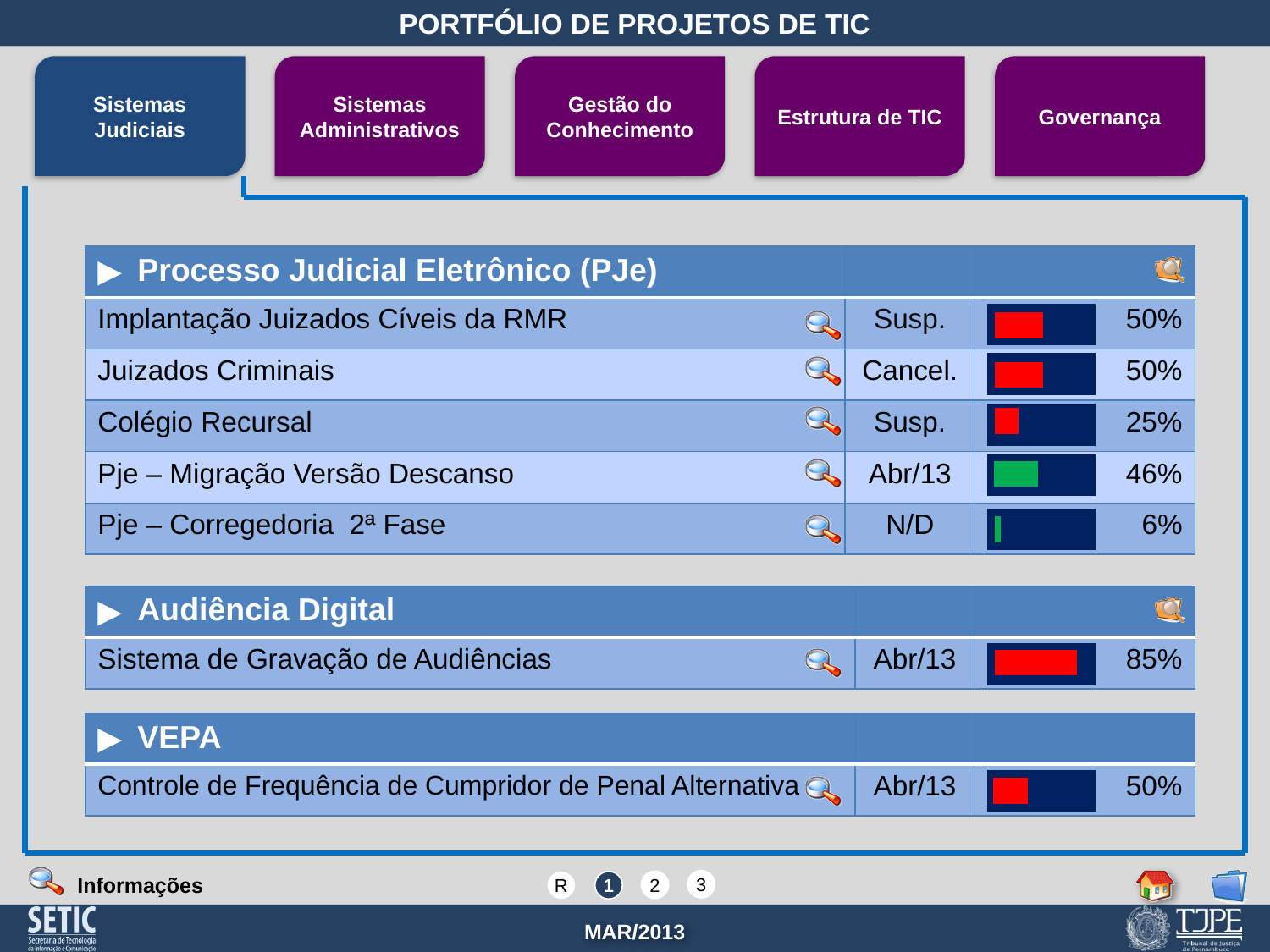
What completion percentage is shown for the project 'Sistema de Gravação de Audiências'? 85% How many projects with progress bars are shown on the slide in total? 7 What completion percentage is shown for 'Pje – Migração Versão Descanso'? 46% Which has a higher completion percentage: 'Colégio Recursal' or 'Pje – Migração Versão Descanso'? Pje – Migração Versão Descanso Which project has the lowest completion percentage on the slide? Pje – Corregedoria 2ª Fase What completion percentage is shown for 'Colégio Recursal'? 25% What completion percentage is shown for 'Pje – Corregedoria 2ª Fase'? 6% What is the difference in percentage points between the completion of 'Sistema de Gravação de Audiências' and 'Pje – Corregedoria 2ª Fase'? 79 percentage points Which project has the highest completion percentage on the slide? Sistema de Gravação de Audiências Which project's progress bar is coloured green rather than red? Pje – Migração Versão Descanso and Pje – Corregedoria 2ª Fase How many projects are listed under the 'Processo Judicial Eletrônico (PJe)' section? 5 What kind of chart is used to show each project's completion? Bar chart